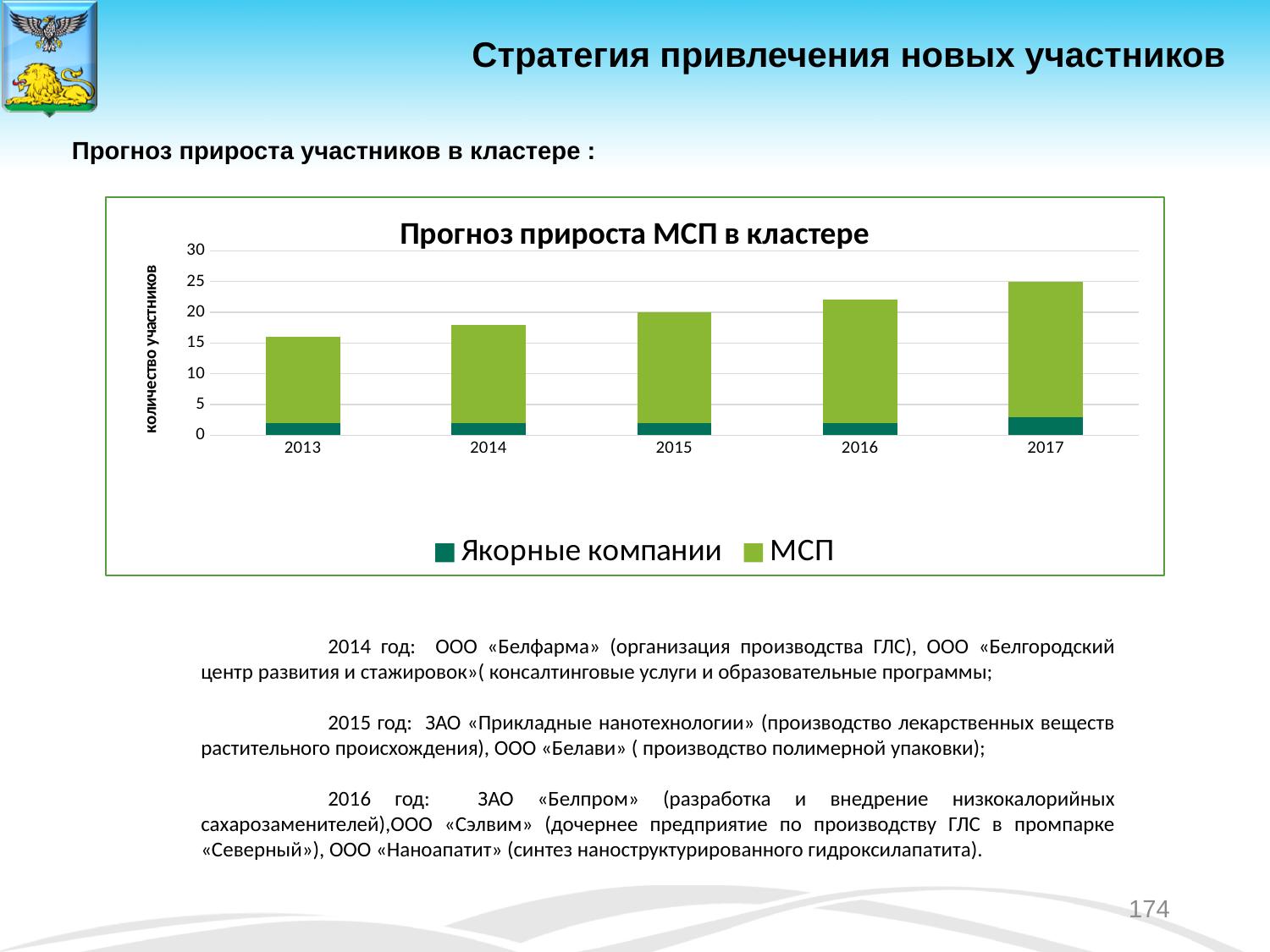
How many years are shown on the x axis of the chart? 5 Which is larger, the total bar for 2014 or the total bar for 2016? 2016 How many series does the legend list? 2 What is the title of the chart? Прогноз прироста МСП в кластере Do the total bar heights rise or fall from 2013 to 2017? rise Is the total value for 2013 greater or less than 20? less Is the total value for 2017 greater or less than 20? greater What kind of chart is shown on the slide? stacked bar chart What is the label on the vertical axis of the chart? количество участников Which year has the lowest total bar in the chart? 2013 Which year has the highest total bar in the chart? 2017 Is the value for Якорные компании in 2016 greater or less than 5? less